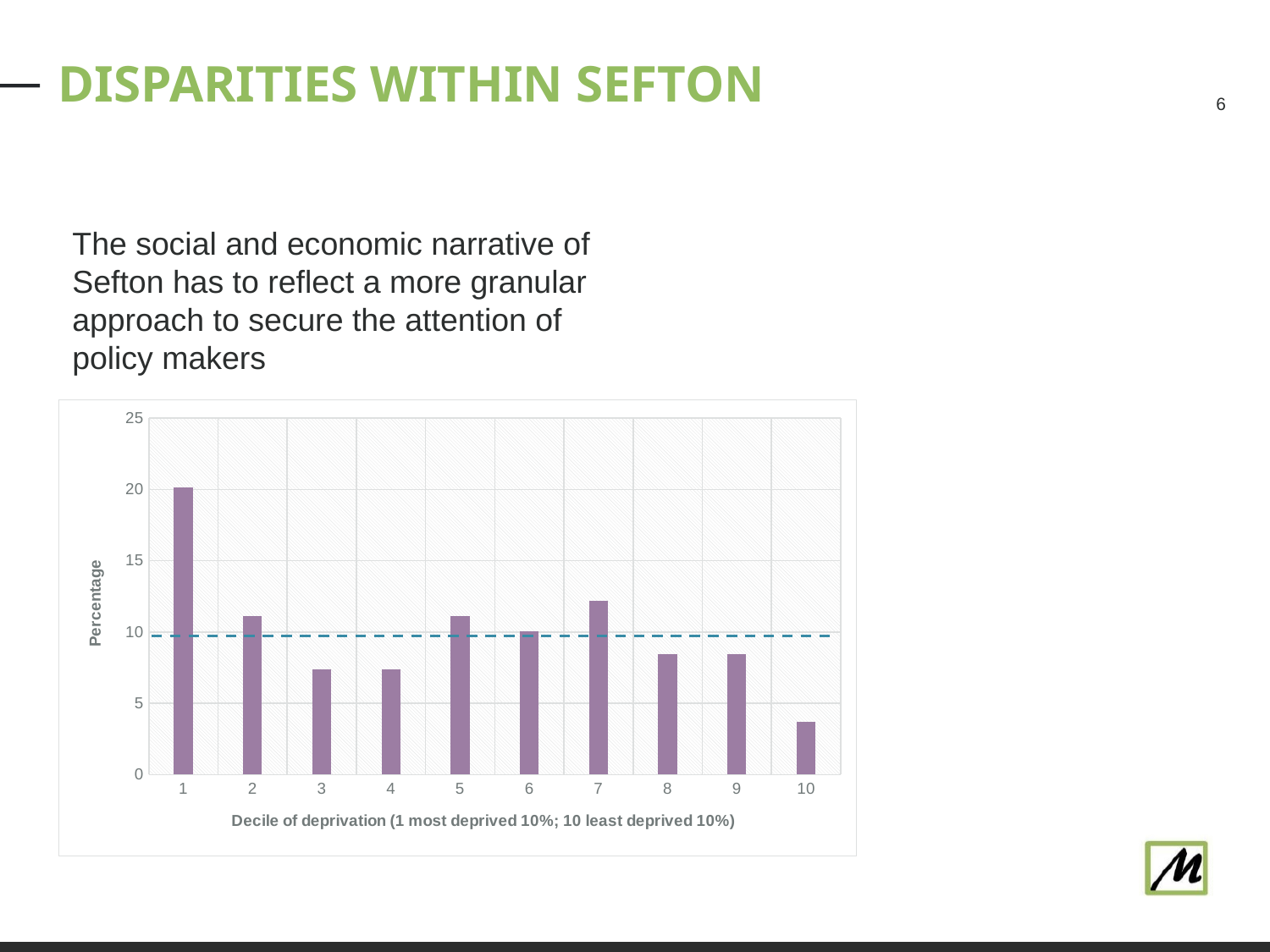
Which decile of deprivation has the highest percentage? 1 Is the percentage for decile 10 greater or less than 5? less How many deciles are plotted on the x axis of the chart? 10 Which has the larger percentage, decile 7 or decile 8? Decile 7 Is the percentage for decile 7 greater or less than 10? greater Is the percentage for decile 1 greater or less than 15? greater What is the label of the x axis of the chart? Decile of deprivation (1 most deprived 10%; 10 least deprived 10%) What kind of chart is shown on the slide? Bar chart What is the label of the y axis of the chart? Percentage Which decile of deprivation has the lowest percentage? 10 Which has the larger percentage, decile 4 or decile 5? Decile 5